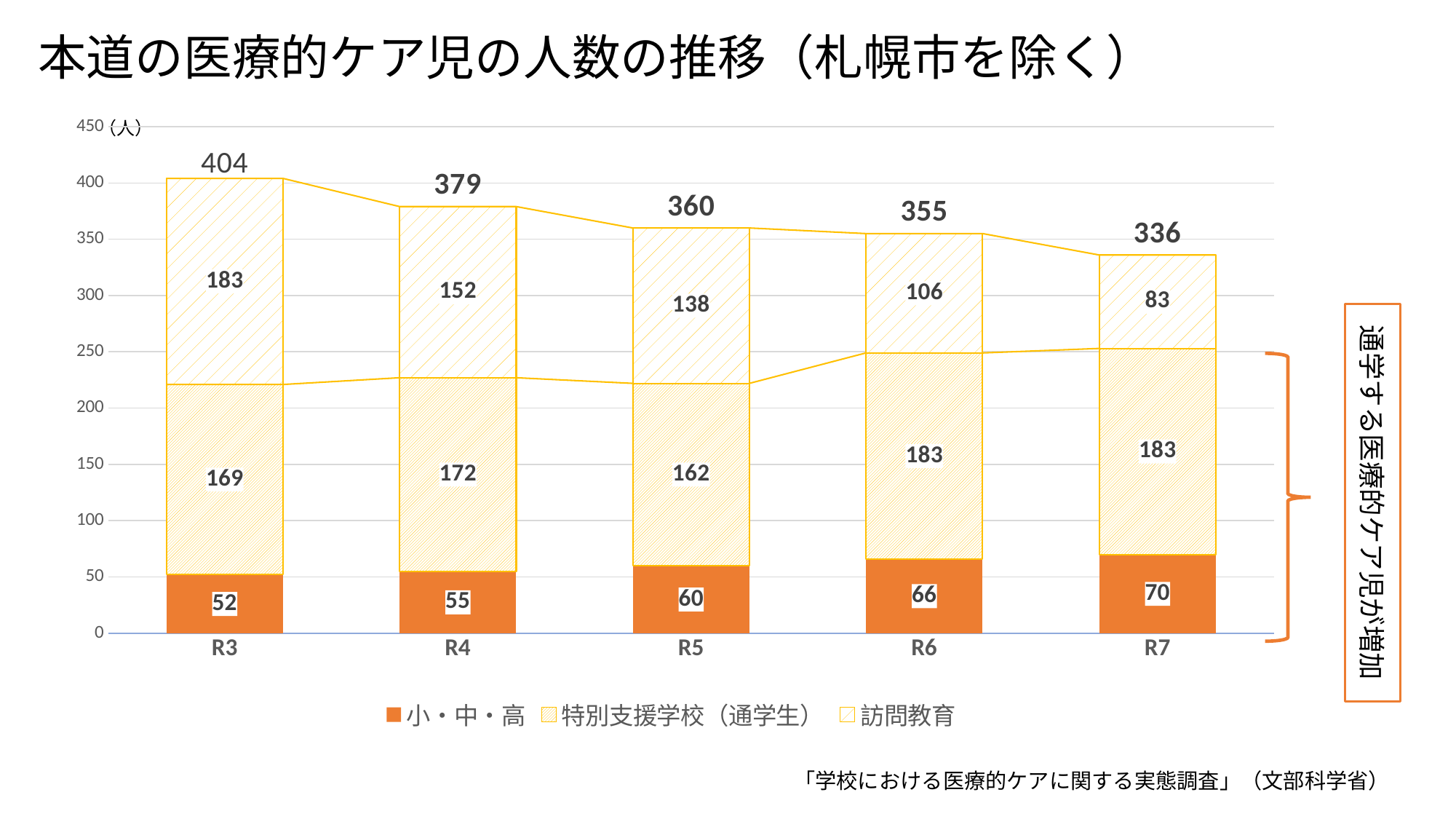
Which year has the lowest value for 訪問教育? R7 What is the total of the stacked bar for R4? 379 How many series does the legend list? 3 Do the totals rise or fall from R3 to R7? Fall Which year has the highest total? R3 What is the difference between the totals for R3 and R7? 68 What kind of chart is shown? Stacked bar chart How many years are shown on the x axis? 5 What is the value for 小・中・高 in R7? 70 Which is larger, the 小・中・高 value in R6 or in R4? R6 What is the value for 特別支援学校（通学生） in R5? 162 What is the value for 訪問教育 in R3? 183